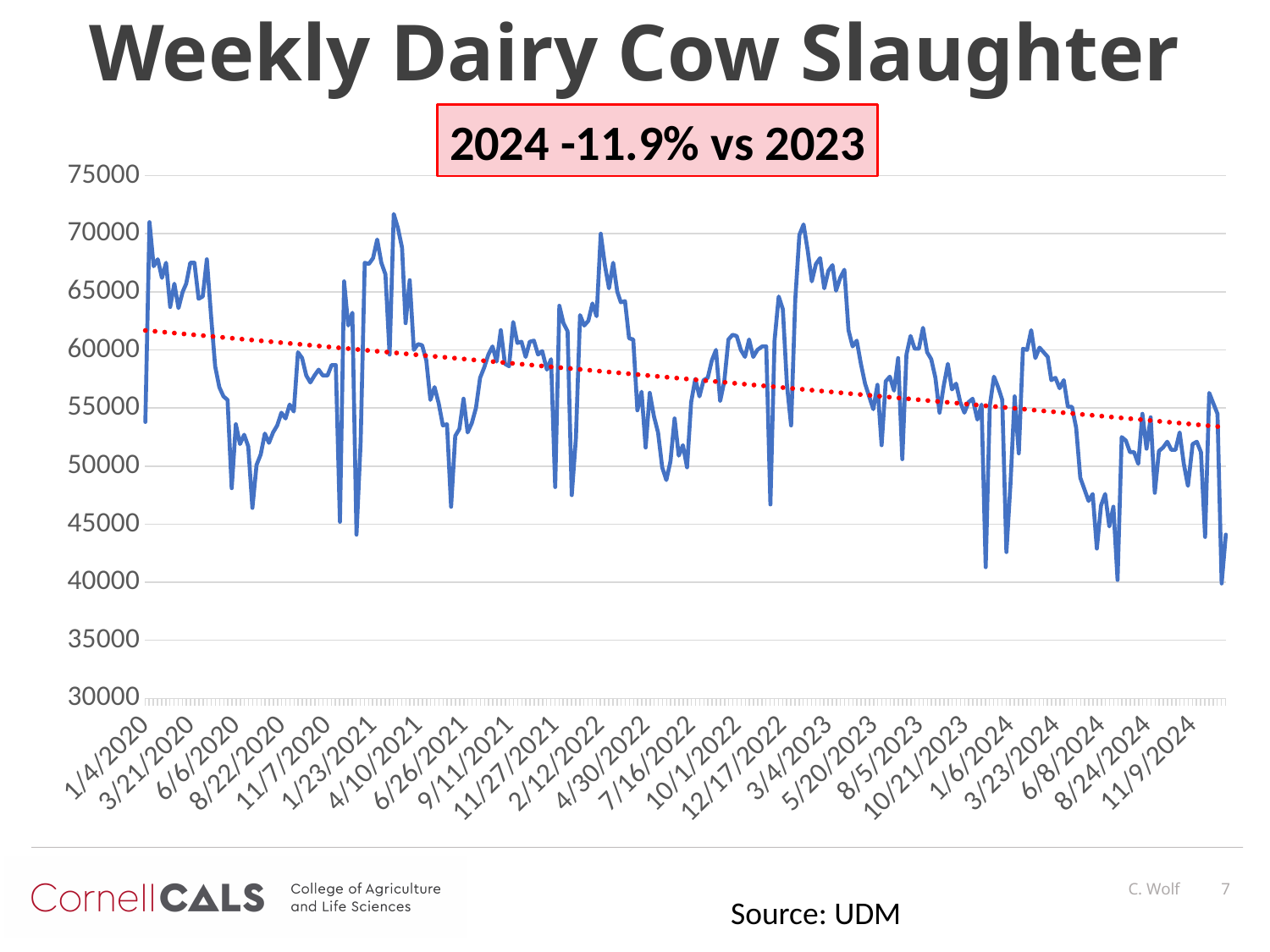
What is the title of the chart? Weekly Dairy Cow Slaughter What is the first date label on the horizontal axis? 1/4/2020 What is the highest value shown on the vertical axis? 75000 Is the highest weekly value on the chart greater or less than 70000? greater What does the highlighted annotation box on the chart say? 2024 -11.9% vs 2023 Do the weekly dairy cow slaughter values generally rise or fall from 2020 to 2024? fall What kind of chart is shown on the slide? line chart Is the dotted trend line at the left end of the chart greater or less than 60000? greater What is the last date label on the horizontal axis? 11/9/2024 Is the dotted trend line at the right end of the chart greater or less than 55000? less What is the lowest value shown on the vertical axis? 30000